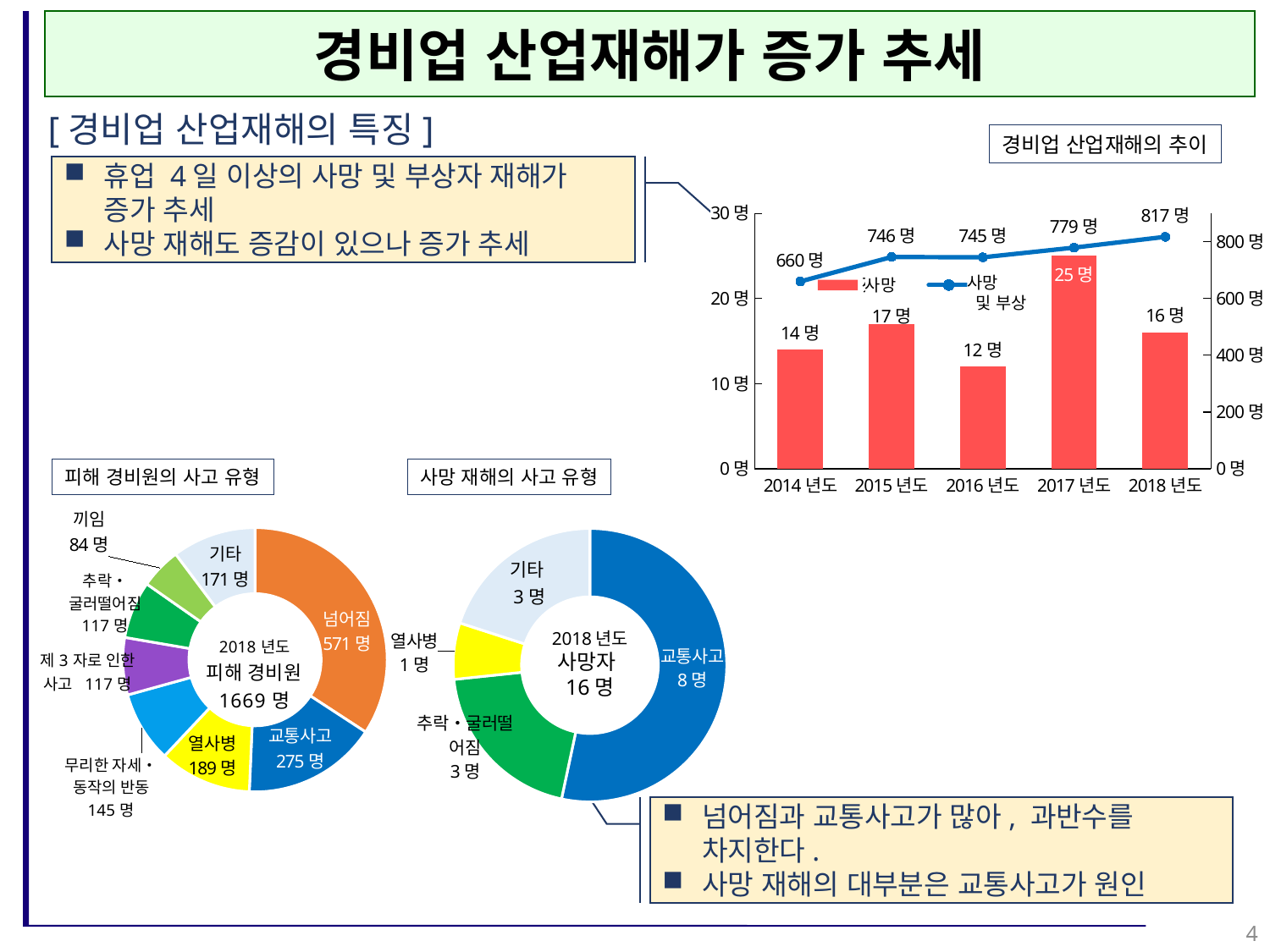
In the chart titled 경비업 산업재해의 추이, how many series does the legend list? 2 In the chart titled 피해 경비원의 사고 유형, what is the value for 열사병? 189 명 In the chart titled 피해 경비원의 사고 유형, which is larger, 교통사고 or 기타? 교통사고 In the chart titled 경비업 산업재해의 추이, what is the difference between the 사망 및 부상 values for 2018 년도 and 2014 년도? 157 명 In the chart titled 경비업 산업재해의 추이, how many years are shown on the x axis? 5 In the chart titled 경비업 산업재해의 추이, which year has the lowest 사망 value? 2016 년도 In the chart titled 사망 재해의 사고 유형, what is the value for 교통사고? 8 명 In the chart titled 경비업 산업재해의 추이, does the 사망 및 부상 line rise or fall from 2016 년도 to 2018 년도? rise In the chart titled 경비업 산업재해의 추이, what is the 사망 및 부상 value for 2018 년도? 817 명 What kind of chart is the one titled 사망 재해의 사고 유형? Donut (pie) chart In the chart titled 피해 경비원의 사고 유형, which category has the largest value? 넘어짐 In the chart titled 경비업 산업재해의 추이, what is the 사망 value for 2017 년도? 25 명